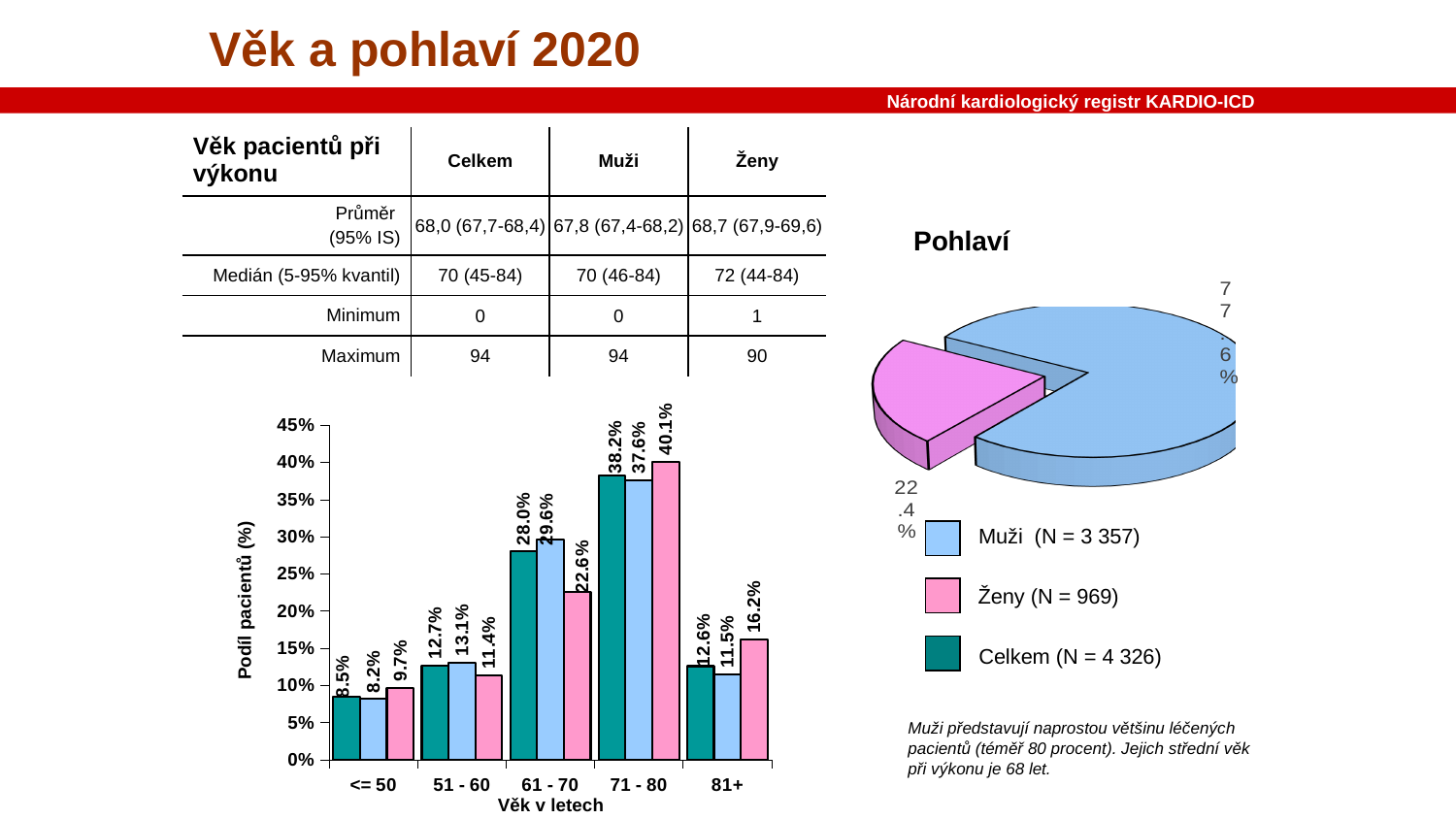
In the Pohlaví pie chart, what share of patients are Ženy? 22.4% In the bar chart, what is the difference between the Ženy and Muži values in the 71 - 80 age group? 2.5 percentage points In the bar chart, which age group has the highest value for Celkem? 71 - 80 How many age groups are shown on the x axis of the bar chart? 5 In the bar chart, which age group has the lowest value for Ženy? <= 50 In the bar chart, which is larger in the 61 - 70 age group, the value for Muži or for Ženy? Muži In the bar chart, what is the value for Ženy in the 81+ age group? 16.2% What kind of chart is the chart at the bottom left of the slide? bar chart According to the legend, what is the N for Ženy? 969 In the Pohlaví pie chart, which group has the larger slice, Muži or Ženy? Muži In the bar chart, what is the value for Celkem in the <= 50 age group? 8.5% In the bar chart, what is the value for Muži in the 61 - 70 age group? 29.6%